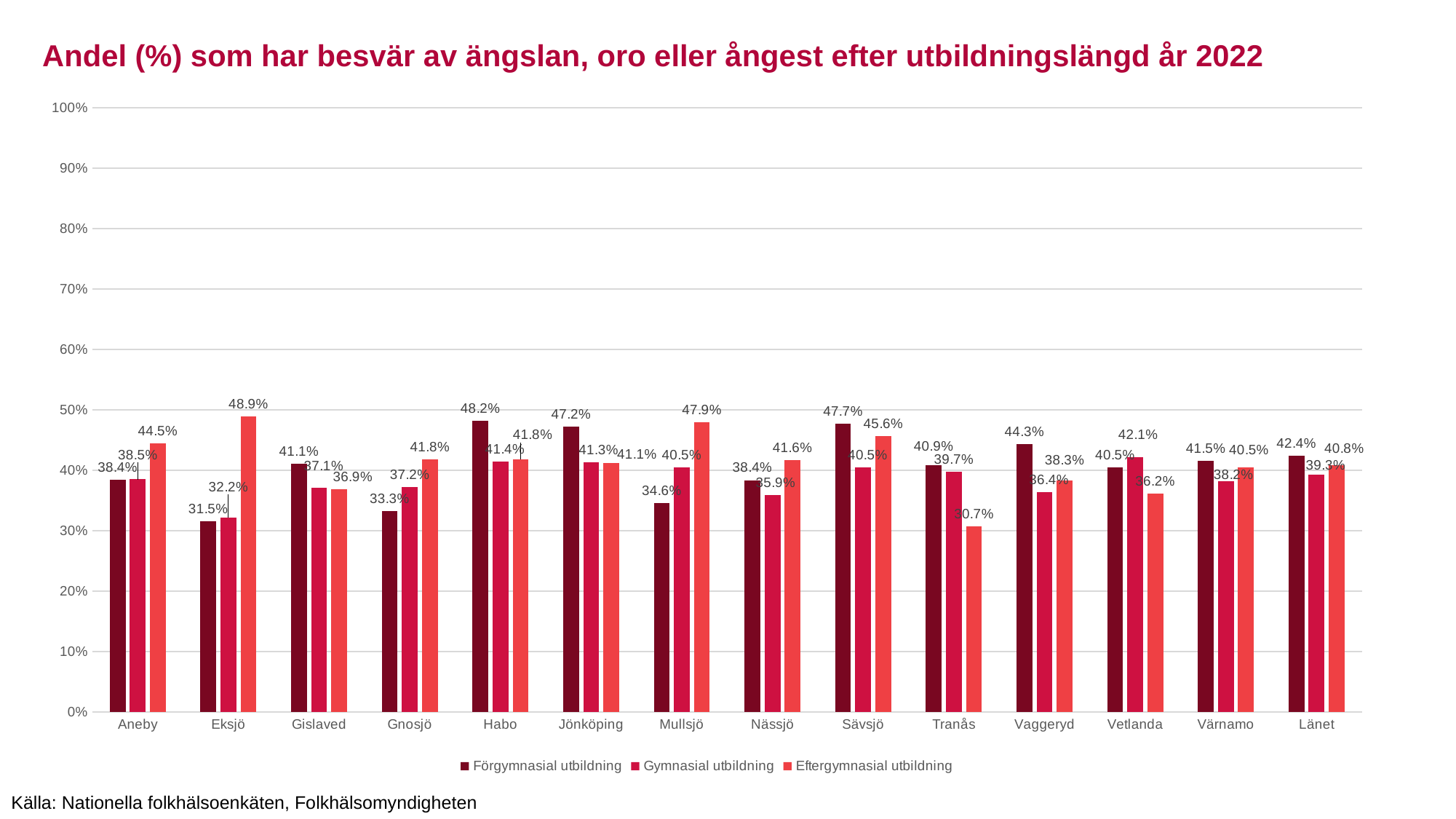
What is the value for Gymnasial utbildning in Länet? 39.3% Which category has the highest value for Eftergymnasial utbildning? Eksjö What is the value for Förgymnasial utbildning in Habo? 48.2% Which category has the lowest value for Förgymnasial utbildning? Eksjö What is the value for Eftergymnasial utbildning in Eksjö? 48.9% How many series does the legend list? 3 Which is larger in Tranås: Förgymnasial utbildning or Eftergymnasial utbildning? Förgymnasial utbildning Which category has the lowest value for Eftergymnasial utbildning? Tranås Is the value for Eftergymnasial utbildning in Mullsjö greater or less than 40%? greater How many categories are shown on the x axis? 14 What is the difference between Eftergymnasial utbildning and Förgymnasial utbildning in Eksjö? 17.4 percentage points What kind of chart is shown on the slide? Bar chart